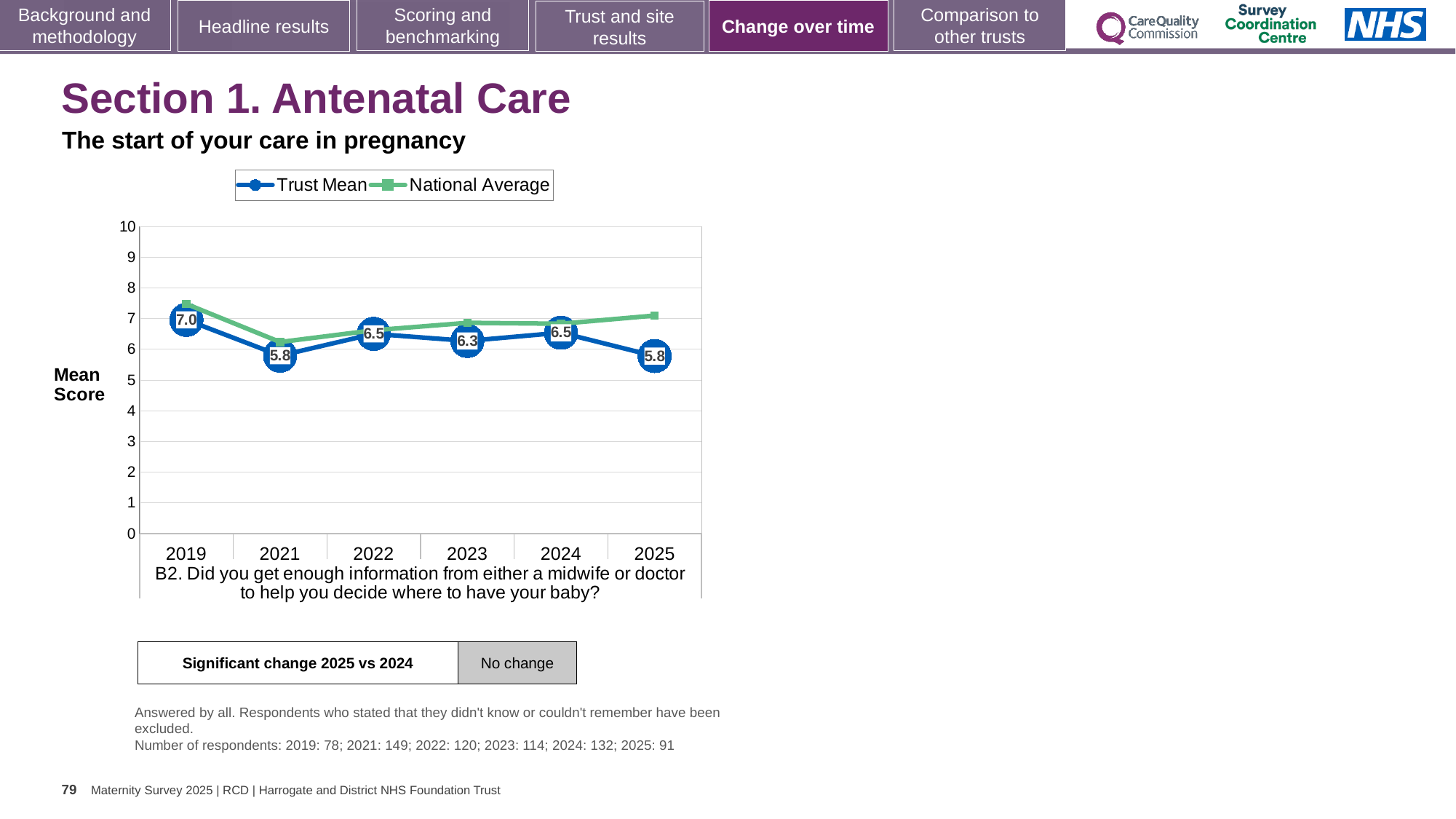
In which year was the Trust Mean score highest? 2019 What is the Trust Mean score for 2025? 5.8 What is the Trust Mean score for 2019? 7.0 Is the National Average value for 2019 greater or less than 7? greater How many series does the chart legend list? 2 What is the Trust Mean score for 2023? 6.3 Did the Trust Mean score rise or fall from 2024 to 2025? Fall What is the difference between the Trust Mean score in 2019 and in 2021? 1.2 How many years are plotted on the x axis of the chart? 6 Which is larger, the Trust Mean score in 2022 or in 2023? 2022 What kind of chart is shown on the slide? Line chart Is the National Average value for 2021 greater or less than 7? less